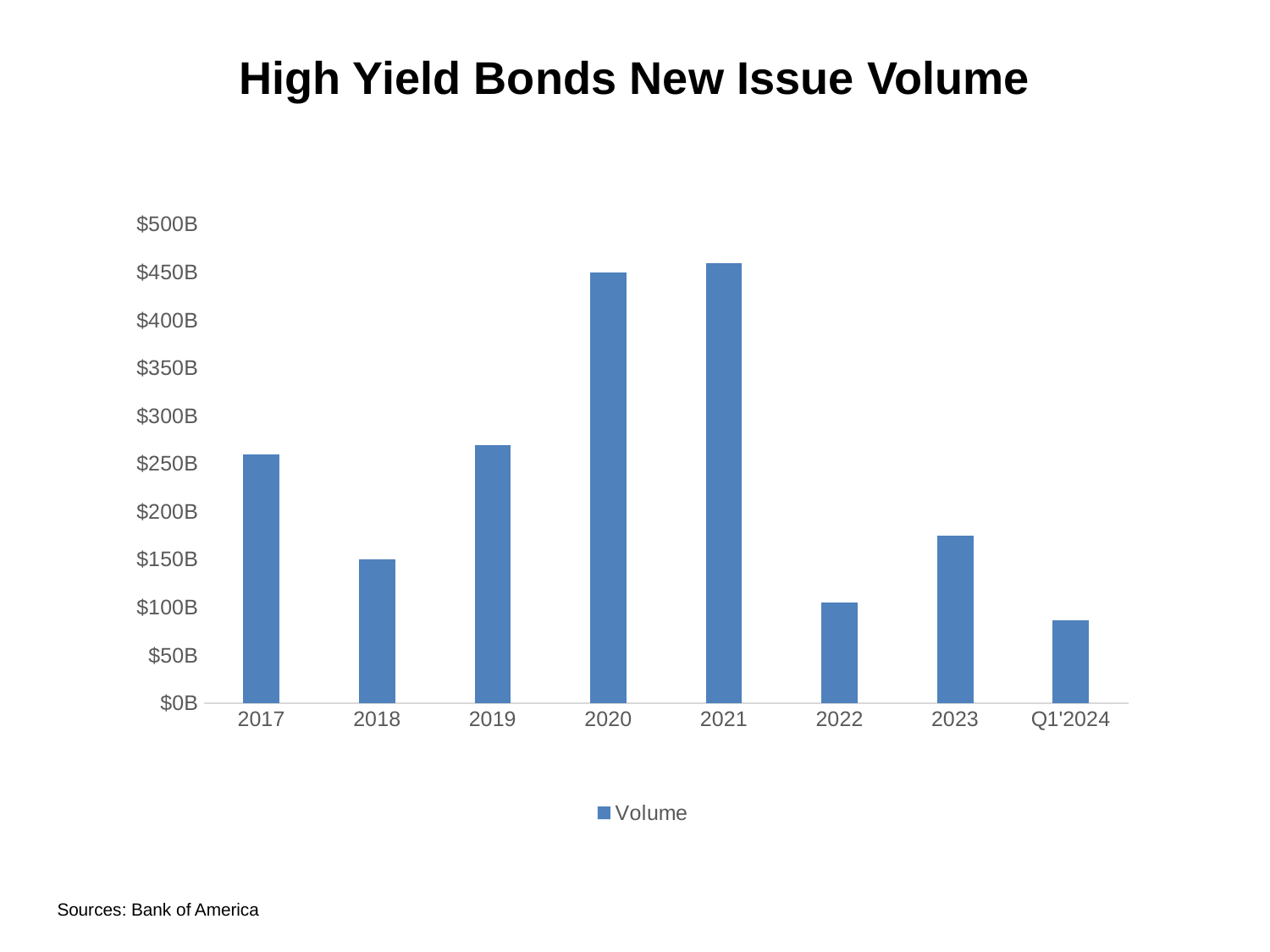
Is the value for 2023 greater or less than $200B? less What is the value for 2020? $450B Which is larger, the value for 2023 or the value for 2022? 2023 How many series does the legend list? 1 Is the value for Q1'2024 greater or less than $100B? less Is the value for 2017 greater or less than $250B? greater Which year has the highest volume? 2021 How many categories are shown on the x axis? 8 What kind of chart is this? bar chart What is the value for 2018? $150B Which year has the lowest volume? Q1'2024